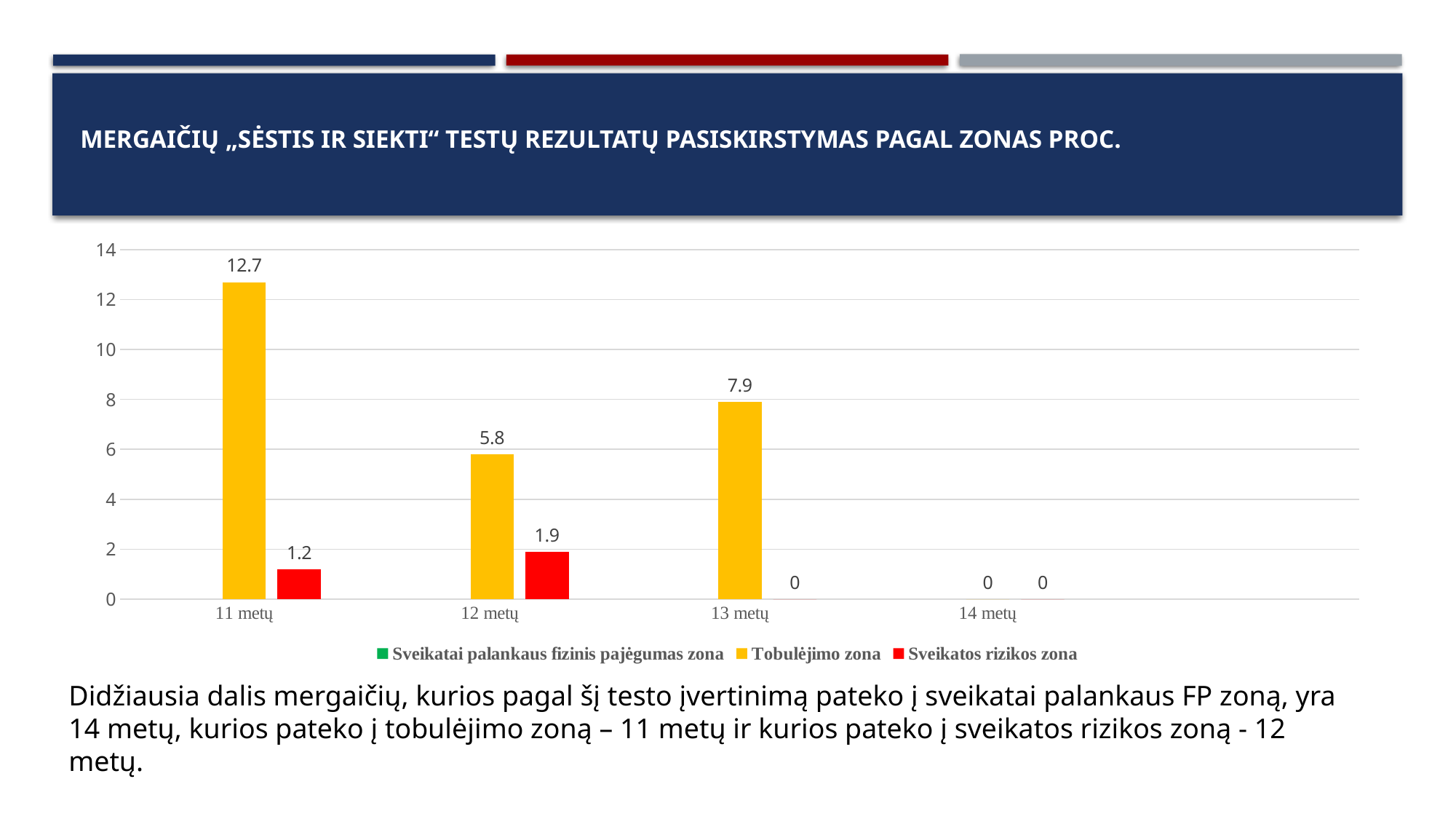
Which is larger: the Sveikatos rizikos zona value for 11 metų or for 12 metų? 12 metų What is the value of Sveikatos rizikos zona for 11 metų? 1.2 What is the value of Tobulėjimo zona for 11 metų? 12.7 What is the difference between the Tobulėjimo zona values for 11 metų and 12 metų? 6.9 How many age groups are shown on the x axis? 4 What is the value of Sveikatos rizikos zona for 12 metų? 1.9 Which age group has the lowest value for Tobulėjimo zona? 14 metų What kind of chart is shown on the slide? Bar chart What colour represents Sveikatos rizikos zona in the chart? Red Which age group has the highest value for Tobulėjimo zona? 11 metų What is the value of Tobulėjimo zona for 13 metų? 7.9 How many series does the legend list? 3